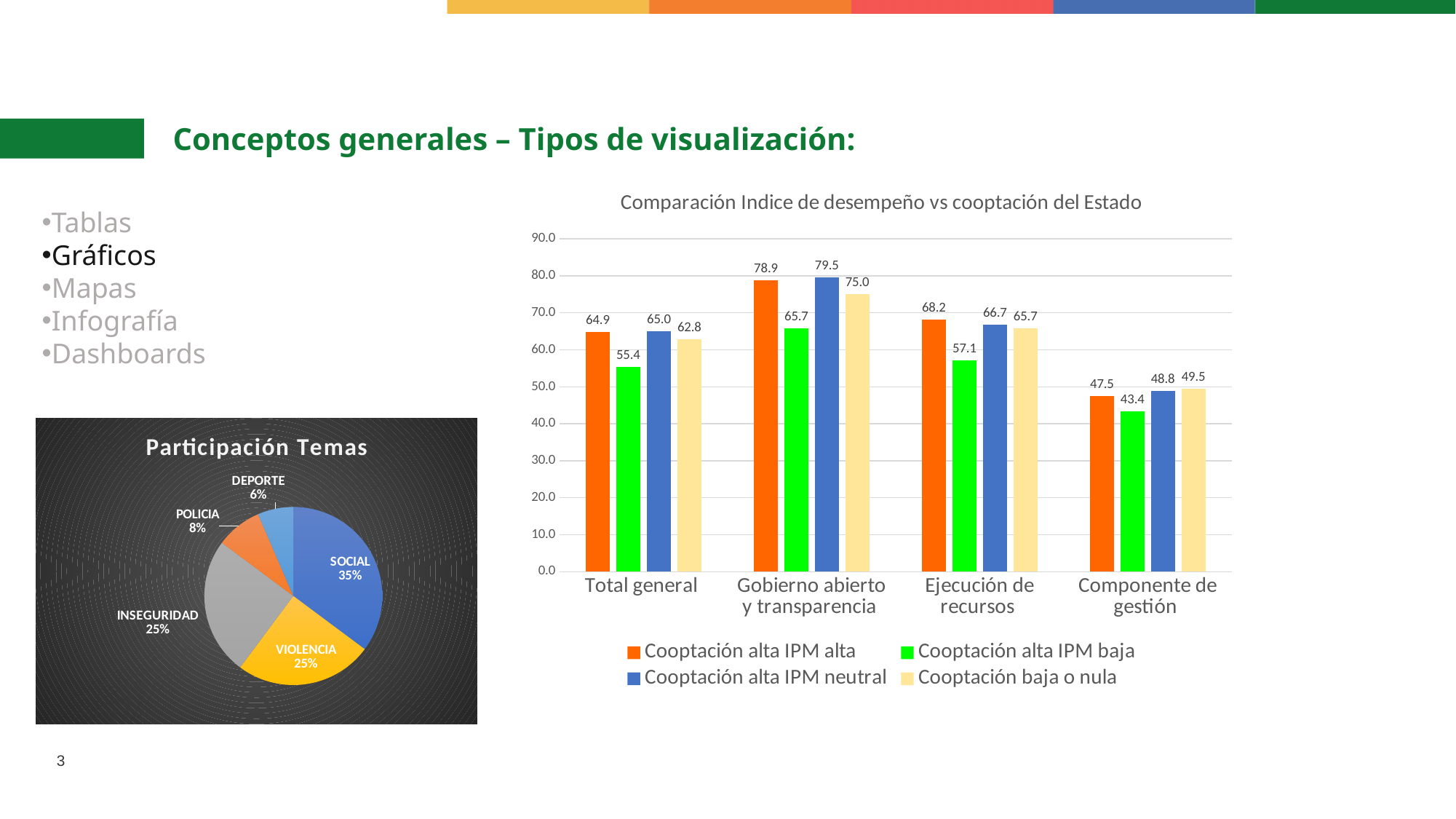
In the 'Participación Temas' chart, which slice is the smallest? DEPORTE What kind of chart is the 'Comparación Indice de desempeño vs cooptación del Estado' chart? Bar chart What kind of chart is the 'Participación Temas' chart? Pie chart In the 'Comparación Indice de desempeño vs cooptación del Estado' chart, which category has the lowest value for 'Cooptación baja o nula'? Componente de gestión How many series does the legend of the 'Comparación Indice de desempeño vs cooptación del Estado' chart list? 4 In the 'Comparación Indice de desempeño vs cooptación del Estado' chart, what is the value for 'Cooptación alta IPM baja' in 'Total general'? 55.4 In the 'Comparación Indice de desempeño vs cooptación del Estado' chart, what is the difference between 'Cooptación alta IPM alta' and 'Cooptación alta IPM baja' in 'Ejecución de recursos'? 11.1 How many categories are shown on the x axis of the 'Comparación Indice de desempeño vs cooptación del Estado' chart? 4 In the 'Comparación Indice de desempeño vs cooptación del Estado' chart, which is larger in 'Componente de gestión': 'Cooptación alta IPM alta' or 'Cooptación baja o nula'? Cooptación baja o nula In the 'Participación Temas' chart, what share does the 'SOCIAL' slice have? 35% In the 'Comparación Indice de desempeño vs cooptación del Estado' chart, what is the value for 'Cooptación alta IPM alta' in 'Gobierno abierto y transparencia'? 78.9 In the 'Comparación Indice de desempeño vs cooptación del Estado' chart, which category has the highest value for 'Cooptación alta IPM neutral'? Gobierno abierto y transparencia